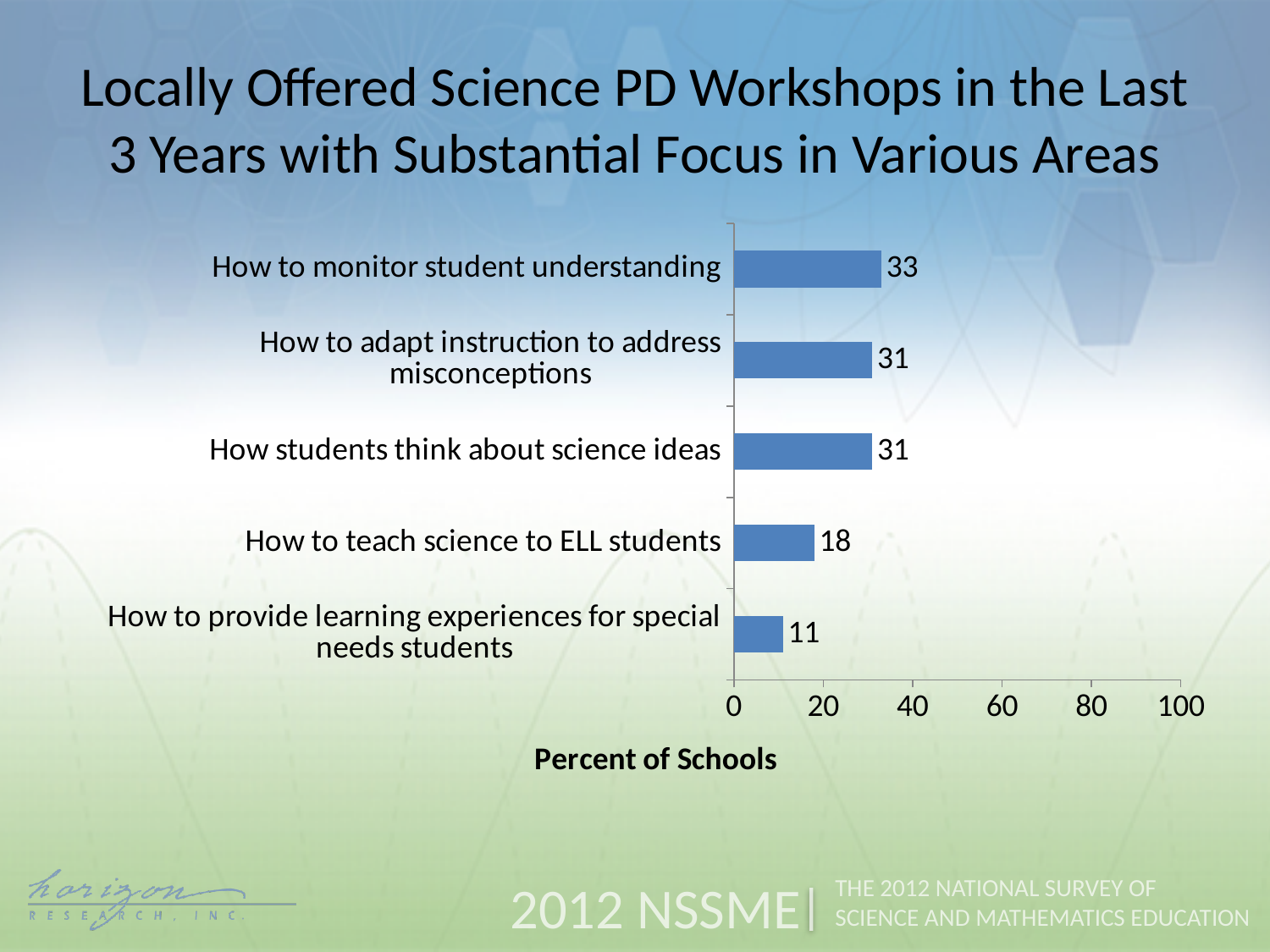
What is the value for 'How to teach science to ELL students'? 18 What is the label of the horizontal axis? Percent of Schools Which category has the highest percent of schools? How to monitor student understanding What is the value for 'How to provide learning experiences for special needs students'? 11 Which is larger: the value for 'How to teach science to ELL students' or for 'How to provide learning experiences for special needs students'? How to teach science to ELL students What kind of chart is shown on the slide? Bar chart What is the difference between the values for 'How to monitor student understanding' and 'How to provide learning experiences for special needs students'? 22 Is the value for 'How to adapt instruction to address misconceptions' greater or less than 40? less How many categories are shown in the chart? 5 Which category has the lowest percent of schools? How to provide learning experiences for special needs students What is the difference between the values for 'How students think about science ideas' and 'How to teach science to ELL students'? 13 What percent of schools offered workshops focused on how to monitor student understanding? 33